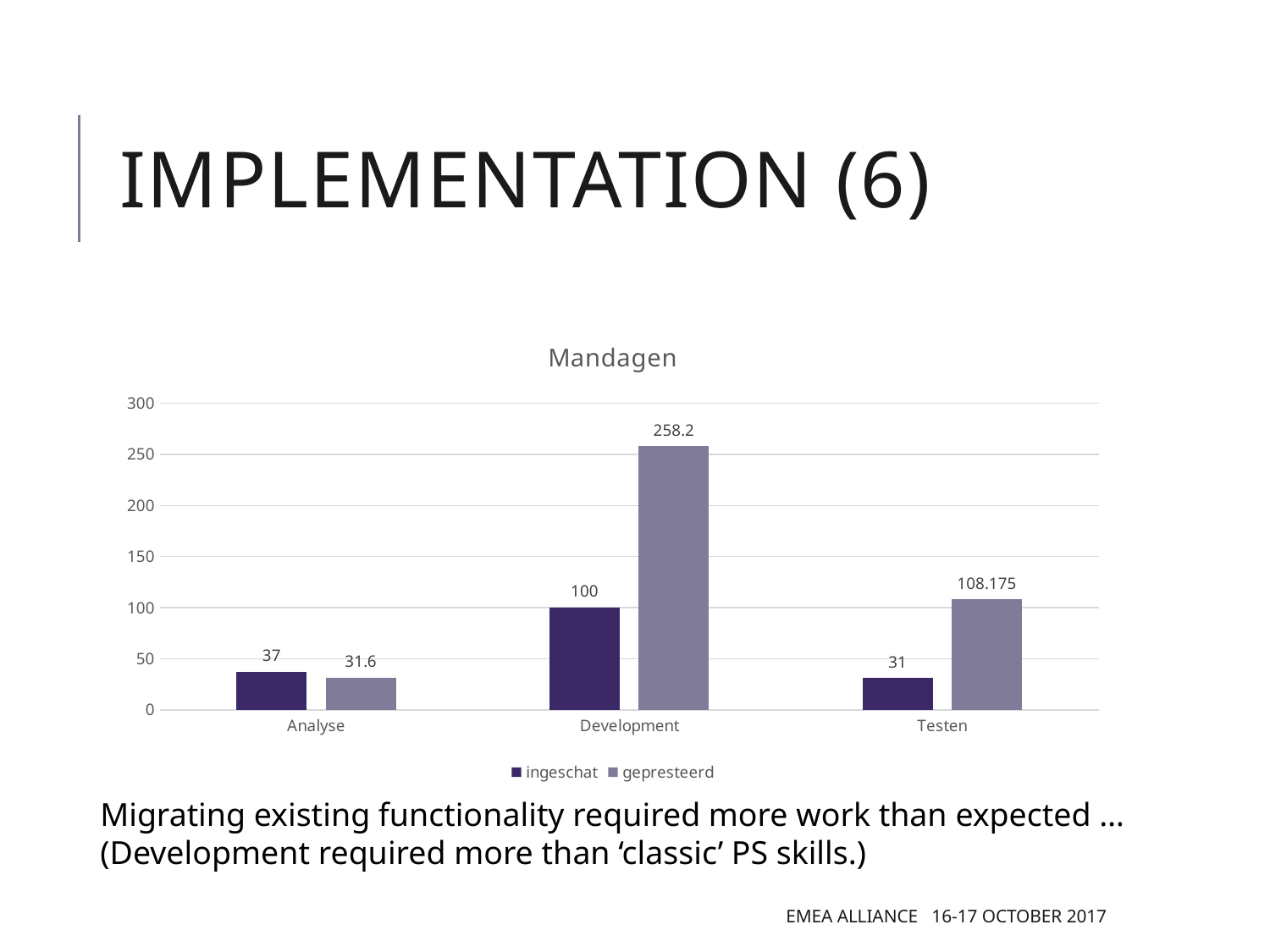
Which category has the highest 'gepresteerd' value? Development What is the 'ingeschat' value for Development? 100 How many series does the legend list? 2 Which category has the lowest 'ingeschat' value? Testen What is the 'gepresteerd' value for Testen? 108.175 Is the 'gepresteerd' value for Development greater or less than 250? greater For Analyse, which is larger: 'ingeschat' or 'gepresteerd'? ingeschat What kind of chart is shown on the slide? bar chart What is the 'gepresteerd' value for Analyse? 31.6 What is the difference between the 'gepresteerd' and 'ingeschat' values for Development? 158.2 How many categories are shown on the x axis? 3 What is the title of the chart? Mandagen